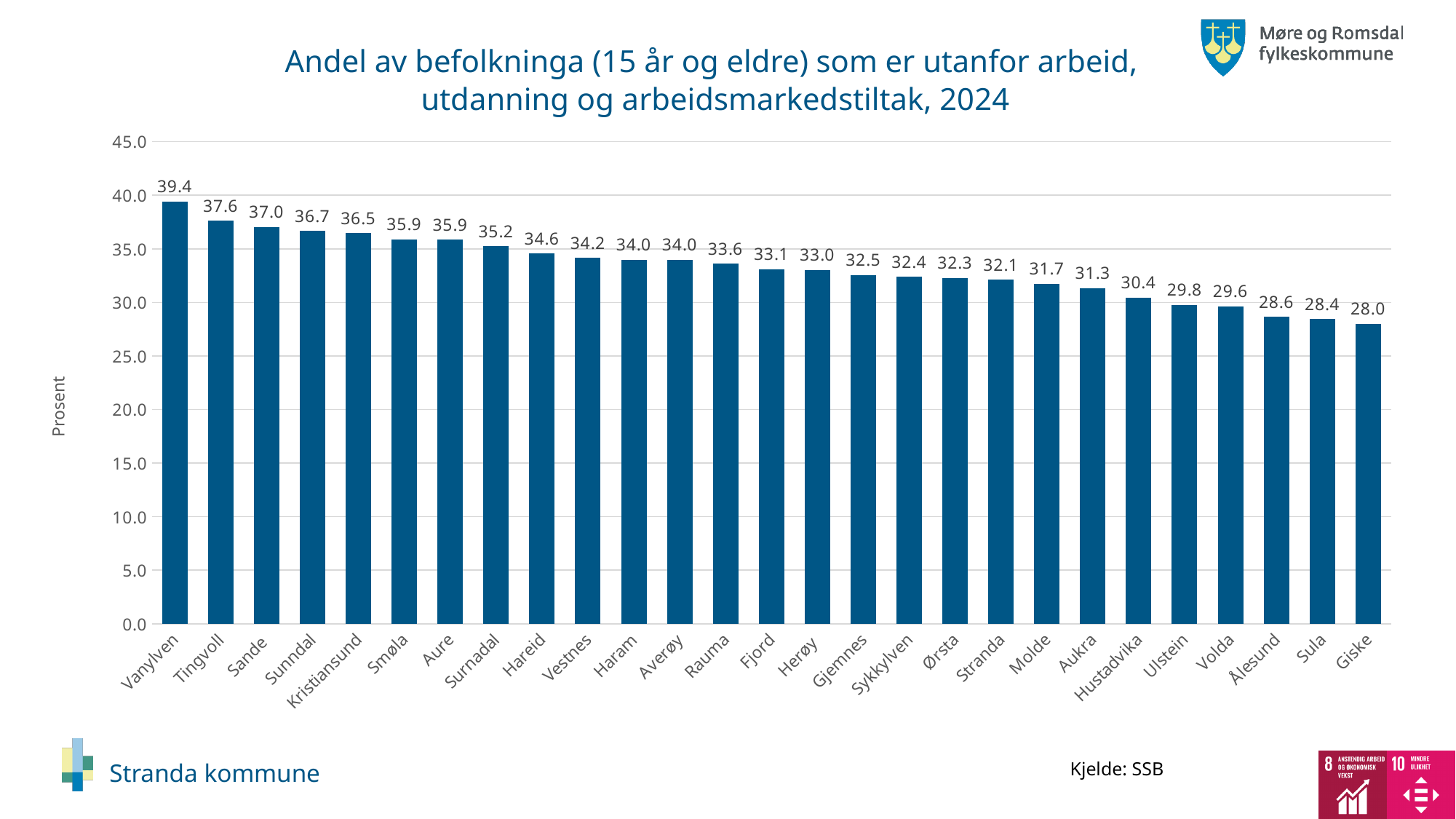
Is the value for Hustadvika greater or less than 35.0? less What kind of chart is shown on the slide? Bar chart What is the value for Molde? 31.7 What is the value for Stranda? 32.1 Which municipality has the lowest value? Giske What is the difference between the values for Vanylven and Giske? 11.4 What is the value for Kristiansund? 36.5 What is the label on the vertical axis? Prosent How many municipalities are shown in the chart? 27 What is the difference between the values for Stranda and Ålesund? 3.5 Which has a larger value, Tingvoll or Sula? Tingvoll Which municipality has the highest value? Vanylven